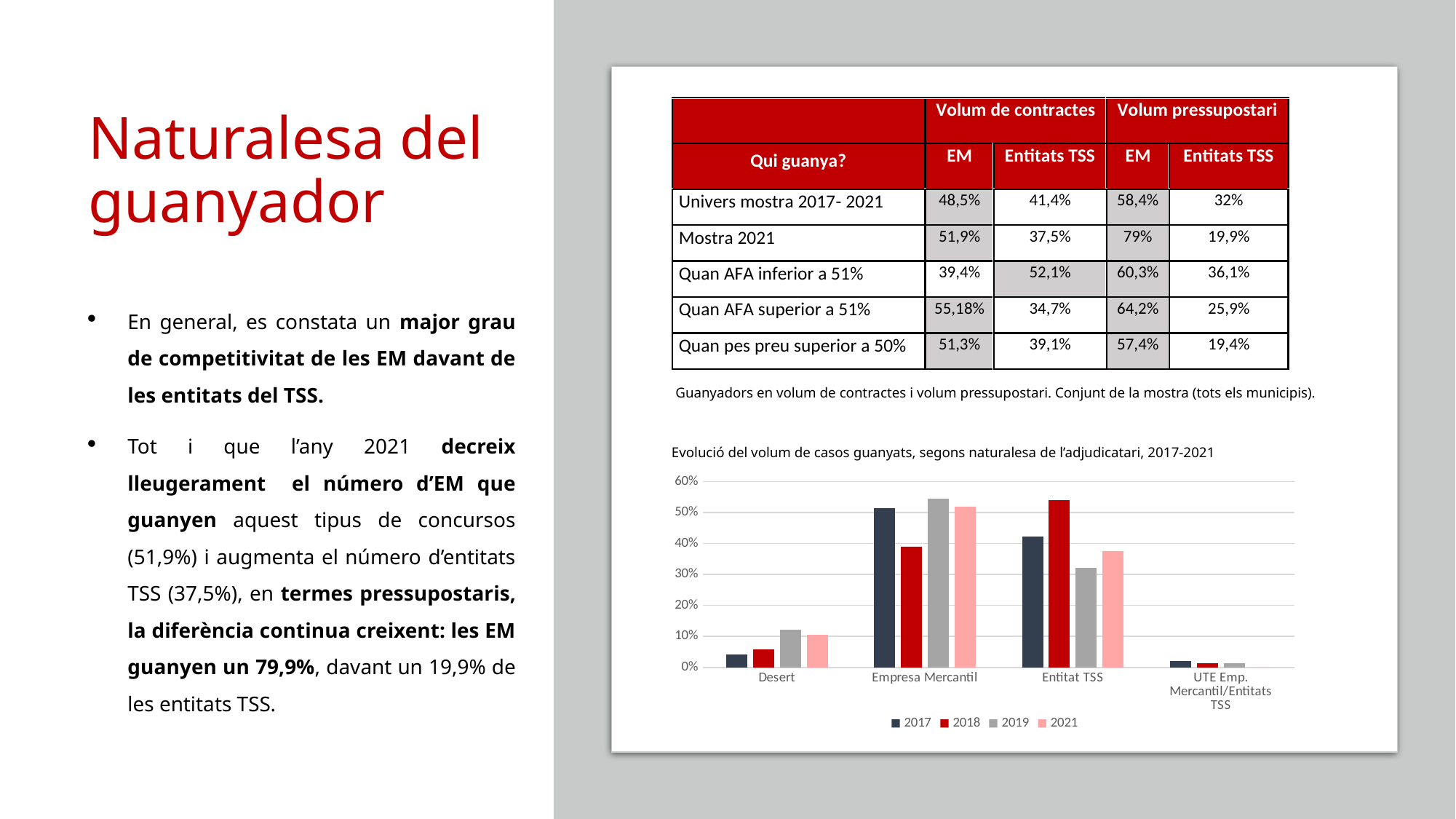
Is the 2019 value for Entitat TSS greater or less than 40%? less How many series does the chart legend list? 4 Which years are listed in the chart legend? 2017, 2018, 2019, 2021 Is the 2019 value for Desert greater or less than 10%? greater Which category has the highest value for the 2018 series? Entitat TSS Which category has the lowest values across all series? UTE Emp. Mercantil/Entitats TSS For Entitat TSS, which is larger: the 2018 value or the 2019 value? 2018 What kind of chart is shown on the slide? bar chart For Empresa Mercantil, which is larger: the 2017 value or the 2018 value? 2017 How many categories are shown on the x axis of the chart? 4 What is the title of the chart? Evolució del volum de casos guanyats, segons naturalesa de l'adjudicatari, 2017-2021 Which category has the highest value for the 2019 series? Empresa Mercantil